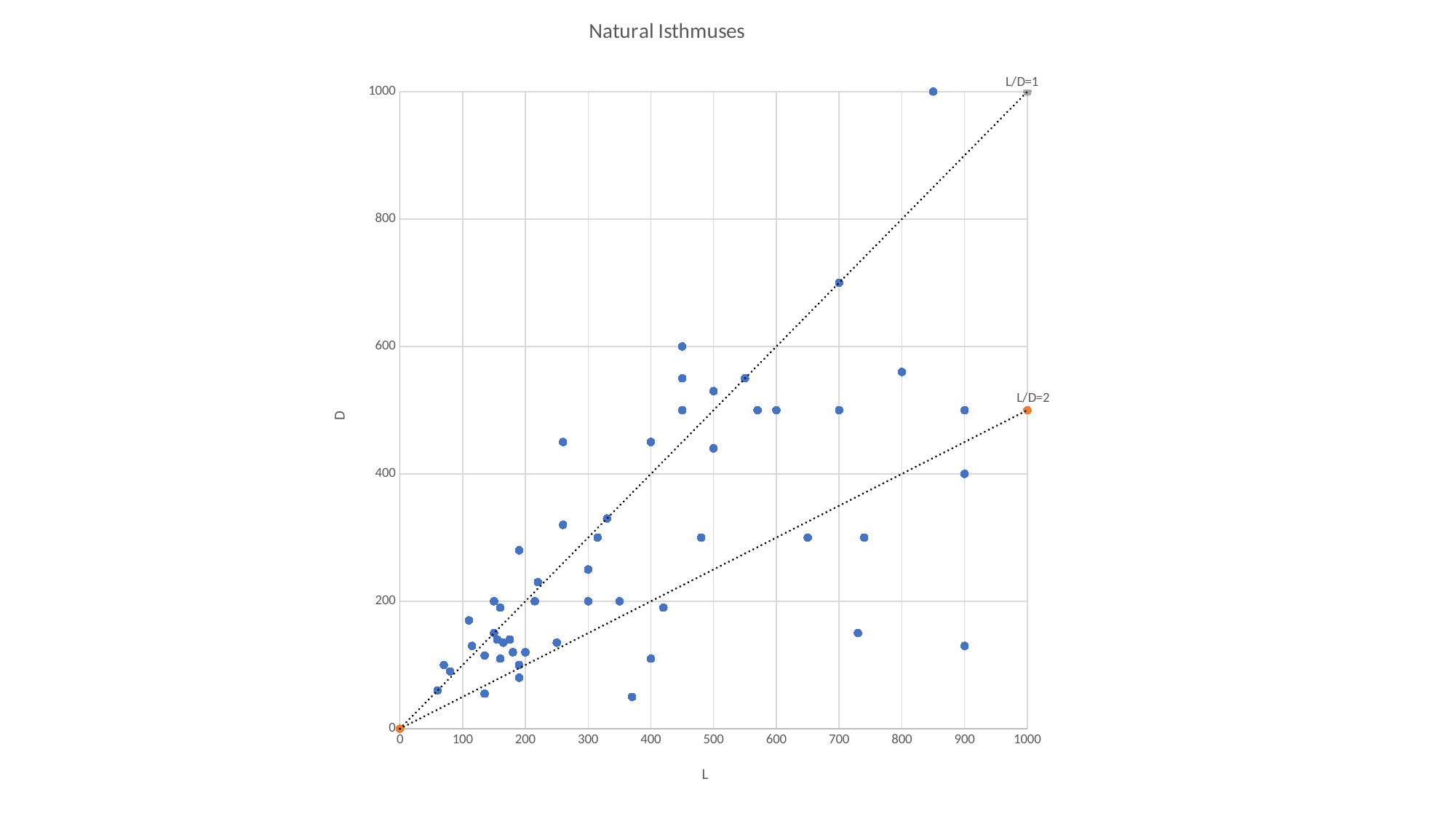
Which is larger, the D value of the blue point at L=800 or the D value of the blue point at L=650? the point at L=800 What are the labels of the two dotted reference lines on the chart? L/D=1 and L/D=2 What is the title of the chart? Natural Isthmuses What kind of chart is shown on the slide? scatter chart Is the D value of the blue point at L=650 greater or less than 400? less Is the D value of the highest plotted blue point greater or less than 800? greater Is the D value of the blue point at L=800 greater or less than 500? greater How many dotted reference lines are drawn on the chart? 2